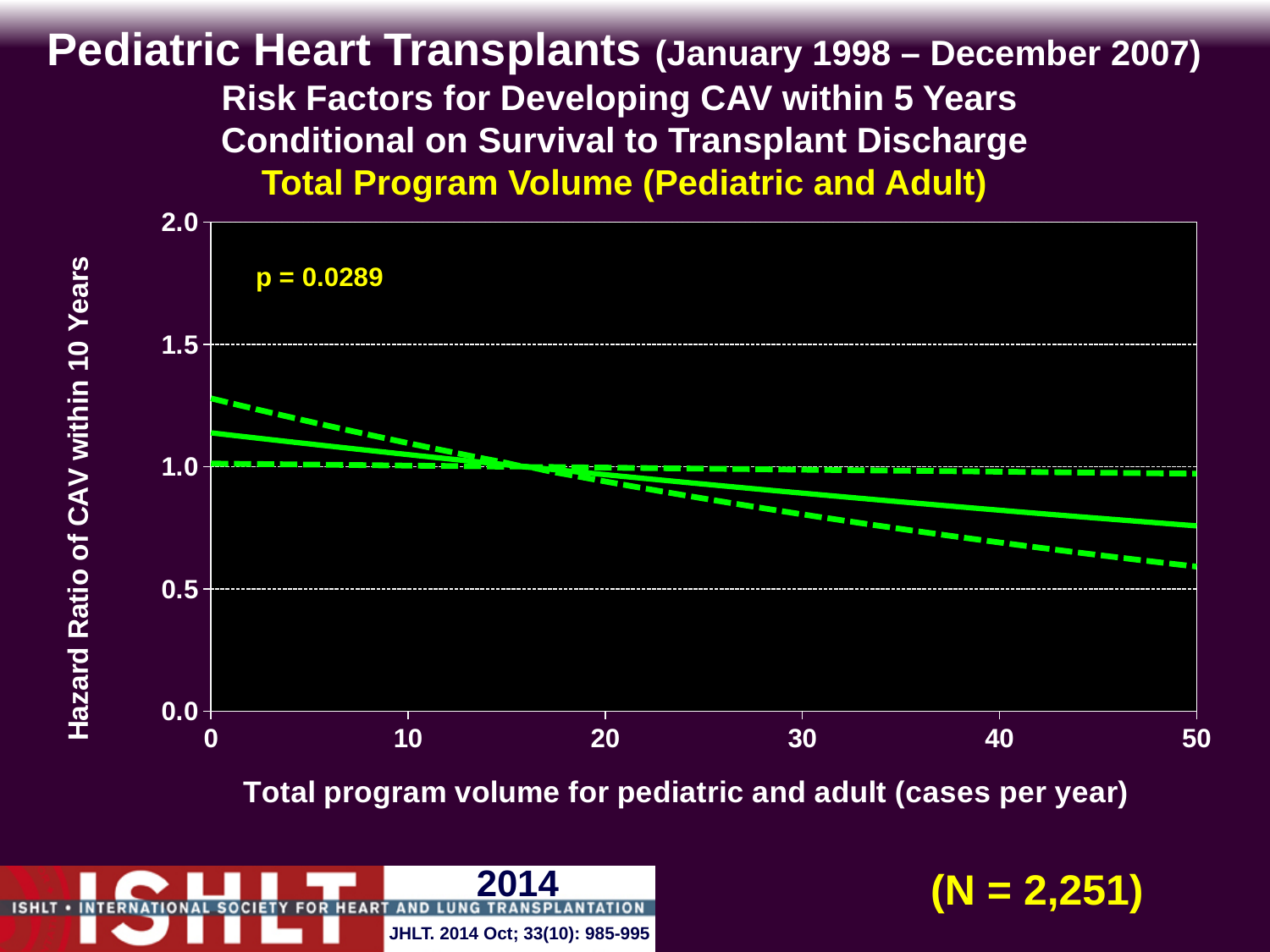
Is the solid hazard ratio line higher at a program volume of 0 or at 50 cases per year? 0 What is the maximum value shown on the y axis? 2.0 What p-value is printed on the chart? p = 0.0289 Does the solid hazard ratio line rise or fall as total program volume increases from 0 to 50 cases per year? fall Is the solid hazard ratio line at a program volume of 50 cases per year greater or less than 1.0? less Is the lower dashed line at a program volume of 50 cases per year greater or less than 0.5? greater Is the solid hazard ratio line at a program volume of 0 cases per year greater or less than 1.0? greater What kind of chart is shown on the slide? line chart How many labelled tick marks are on the x axis? 6 How many lines are plotted on the chart? 3 What sample size (N) is shown on the slide? N = 2,251